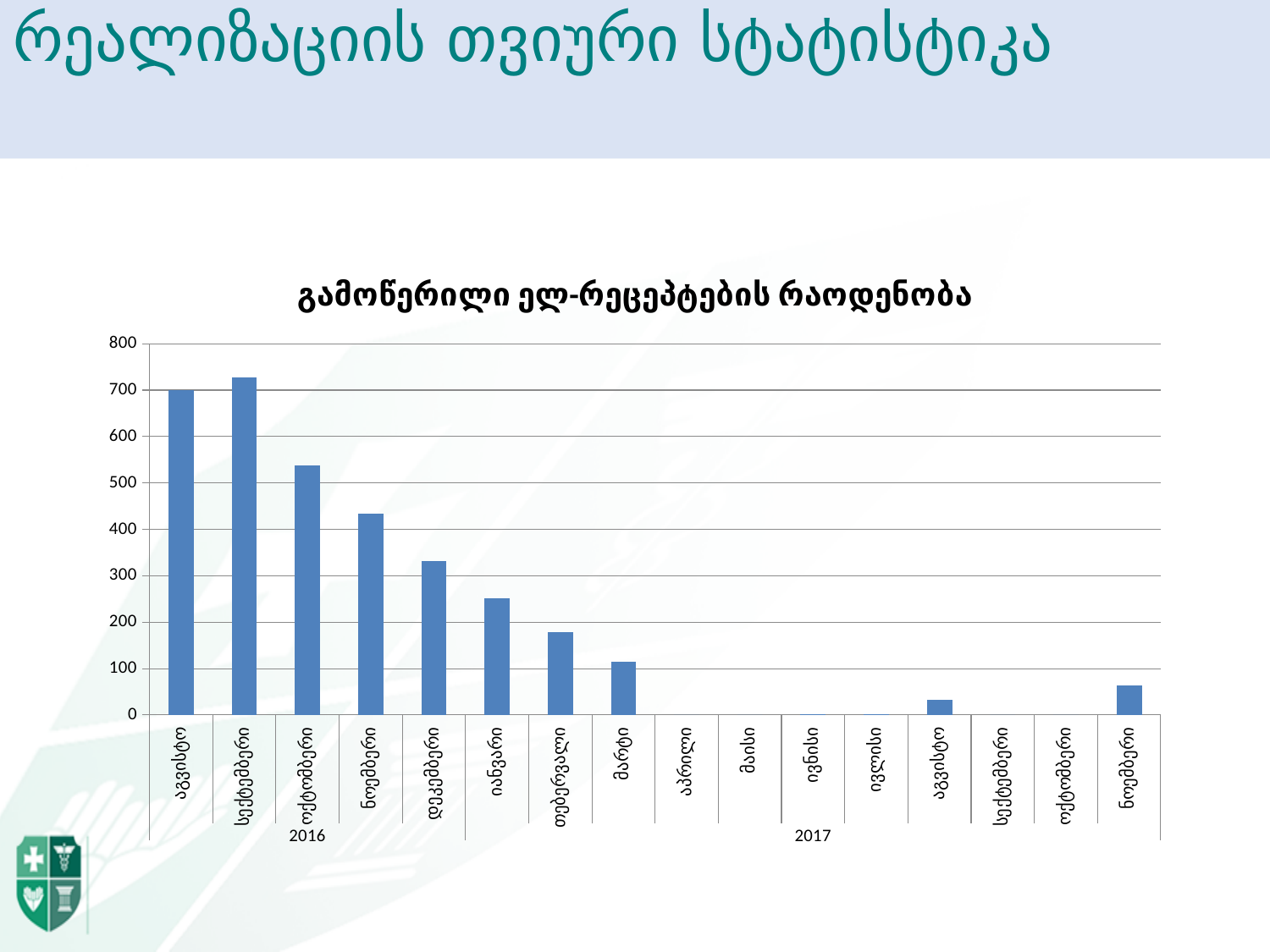
Is the value for ოქტომბერი 2016 greater or less than 500? greater Is the value for ნოემბერი 2017 greater or less than 100? less Which month has the highest value in the chart? სექტემბერი 2016 Is the value for მარტი 2017 greater or less than 200? less How many bars (months) are plotted in the chart? 16 Which is larger, the value for ნოემბერი 2016 or the value for იანვარი 2017? ნოემბერი 2016 What kind of chart is shown on the slide? bar chart What is the title of the chart? გამოწერილი ელ-რეცეპტების რაოდენობა Do the values rise or fall from აგვისტო 2016 to მარტი 2017? fall Which is larger, the value for აგვისტო 2017 or the value for ნოემბერი 2017? ნოემბერი 2017